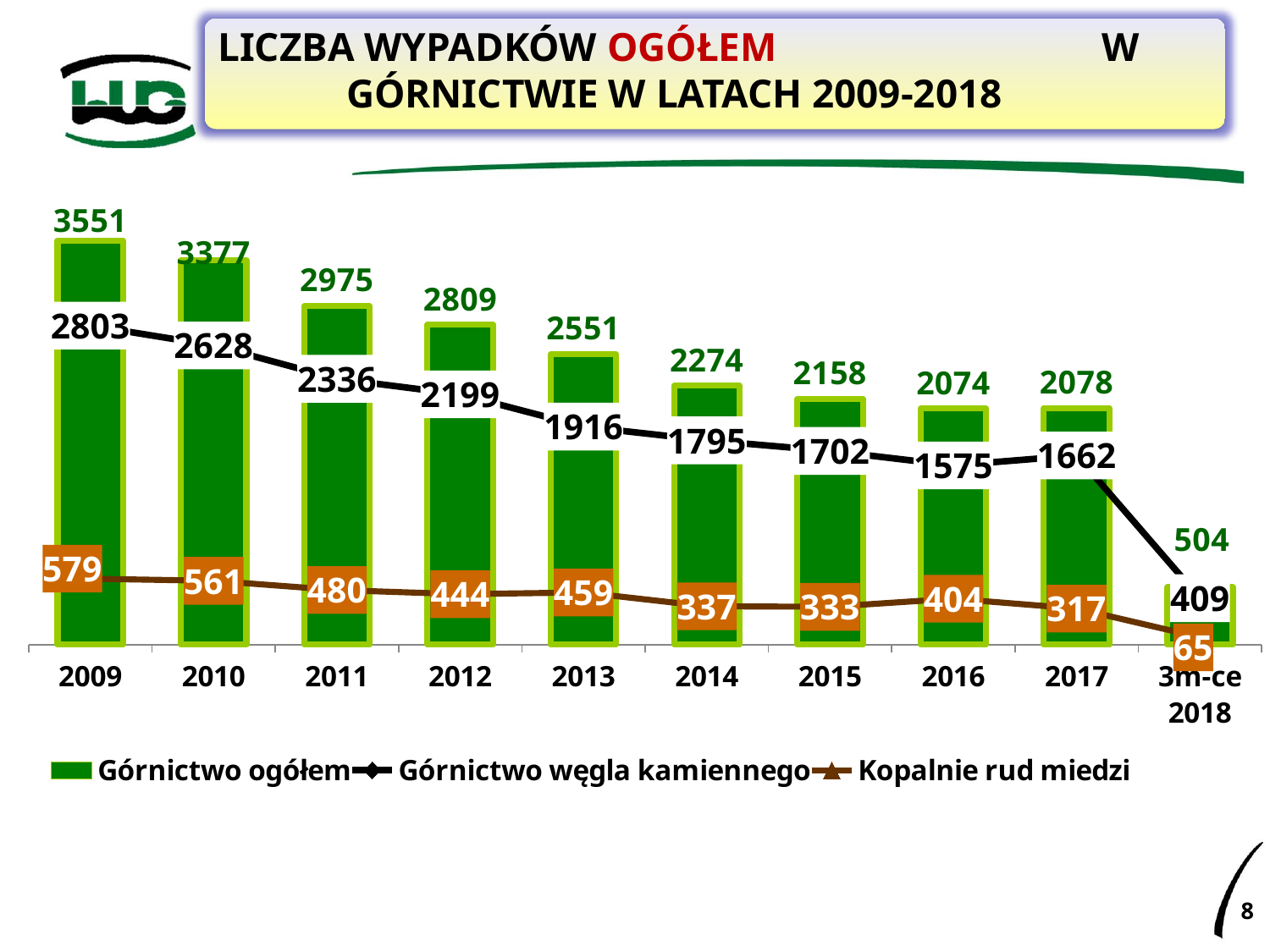
What is the value of Kopalnie rud miedzi for 2016? 404 Which category has the lowest value for Kopalnie rud miedzi? 3m-ce 2018 What is the value of Górnictwo ogółem for 3m-ce 2018? 504 Which series is shown as green bars? Górnictwo ogółem Do the Górnictwo węgla kamiennego values generally rise or fall from 2009 to 2016? fall Which is larger, the Kopalnie rud miedzi value for 2013 or for 2012? 2013 What is the value of Górnictwo węgla kamiennego for 2013? 1916 How many categories are shown on the x axis? 10 What is the value of Górnictwo ogółem for 2009? 3551 Which year has the highest value for Górnictwo ogółem? 2009 What is the difference between the Górnictwo ogółem values for 2009 and 2010? 174 How many series does the legend list? 3